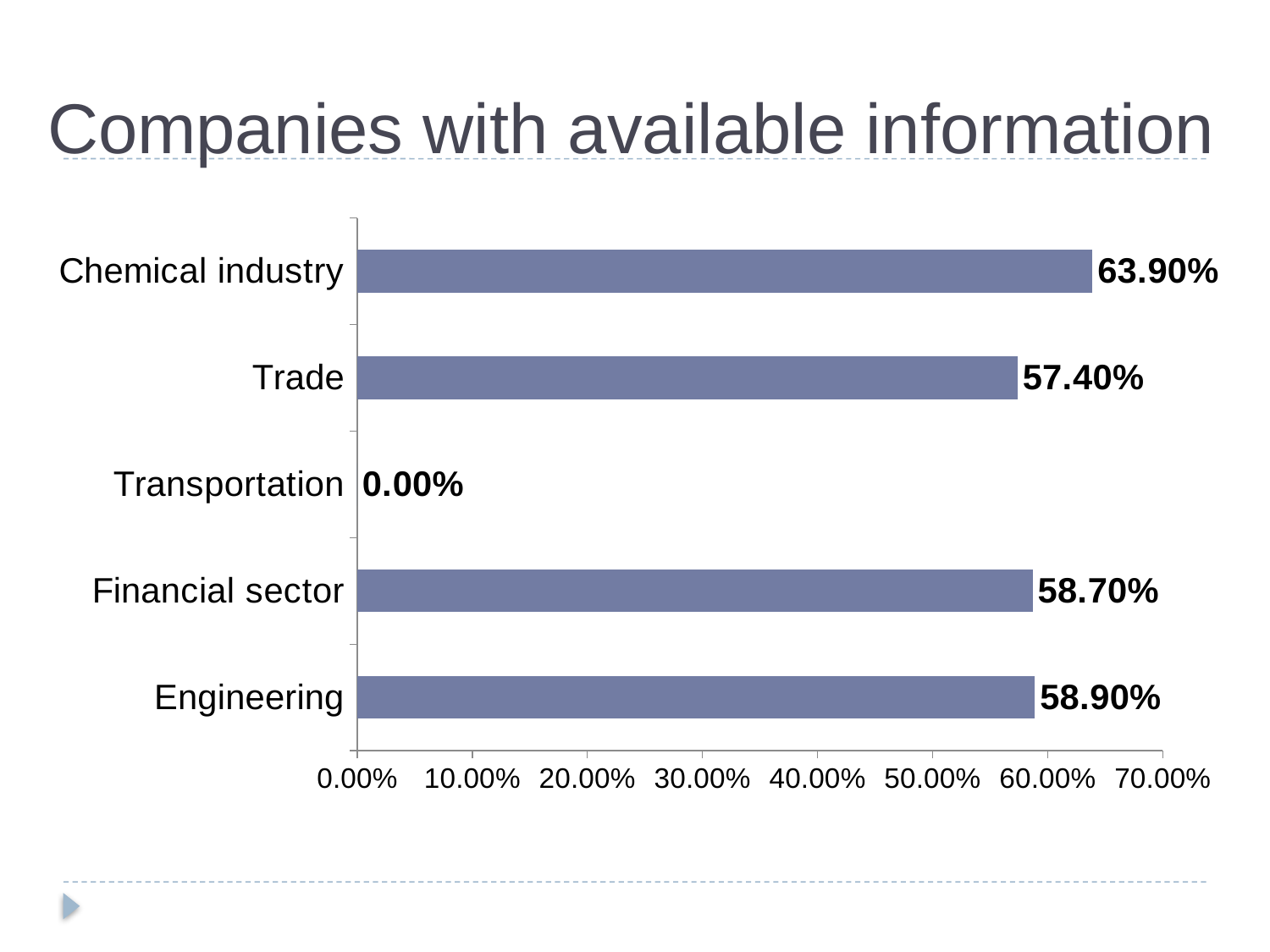
What kind of chart is shown on the slide? Bar chart What is the value for Financial sector? 58.70% Is the value for Trade greater or less than 50.00%? greater What is the difference between the values for Chemical industry and Trade? 6.50% What is the value for Chemical industry? 63.90% What is the value for Transportation? 0.00% Which category has the highest value? Chemical industry What is the value for Engineering? 58.90% Which category has the lowest value? Transportation What is the value for Trade? 57.40% How many categories are shown in the chart? 5 Which is larger, the value for Chemical industry or the value for Financial sector? Chemical industry